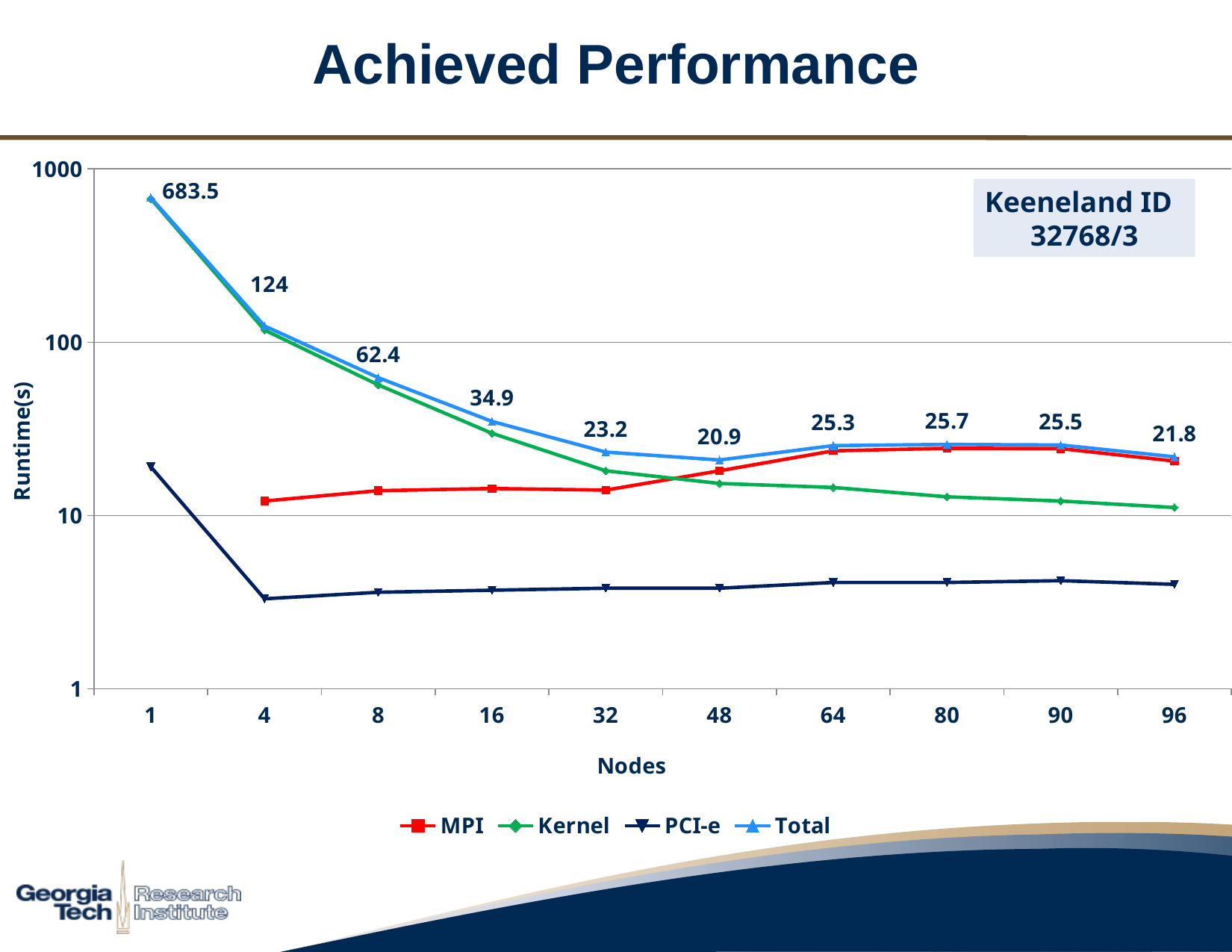
What is the Total runtime at 96 nodes? 21.8 Which has the larger Total runtime, 64 nodes or 80 nodes? 80 nodes What is the Total runtime at 48 nodes? 20.9 What is the Total runtime at 1 node? 683.5 At which node count is the Total runtime highest? 1 Is the Kernel value at 1 node greater or less than 100? greater Is the PCI-e value at 4 nodes greater or less than 10? less How many series does the legend list? 4 How many node counts are shown on the x axis? 10 At which node count is the Total runtime lowest? 48 What is the difference between the Total runtime at 4 nodes and at 8 nodes? 61.6 What kind of chart is shown on the slide? line chart